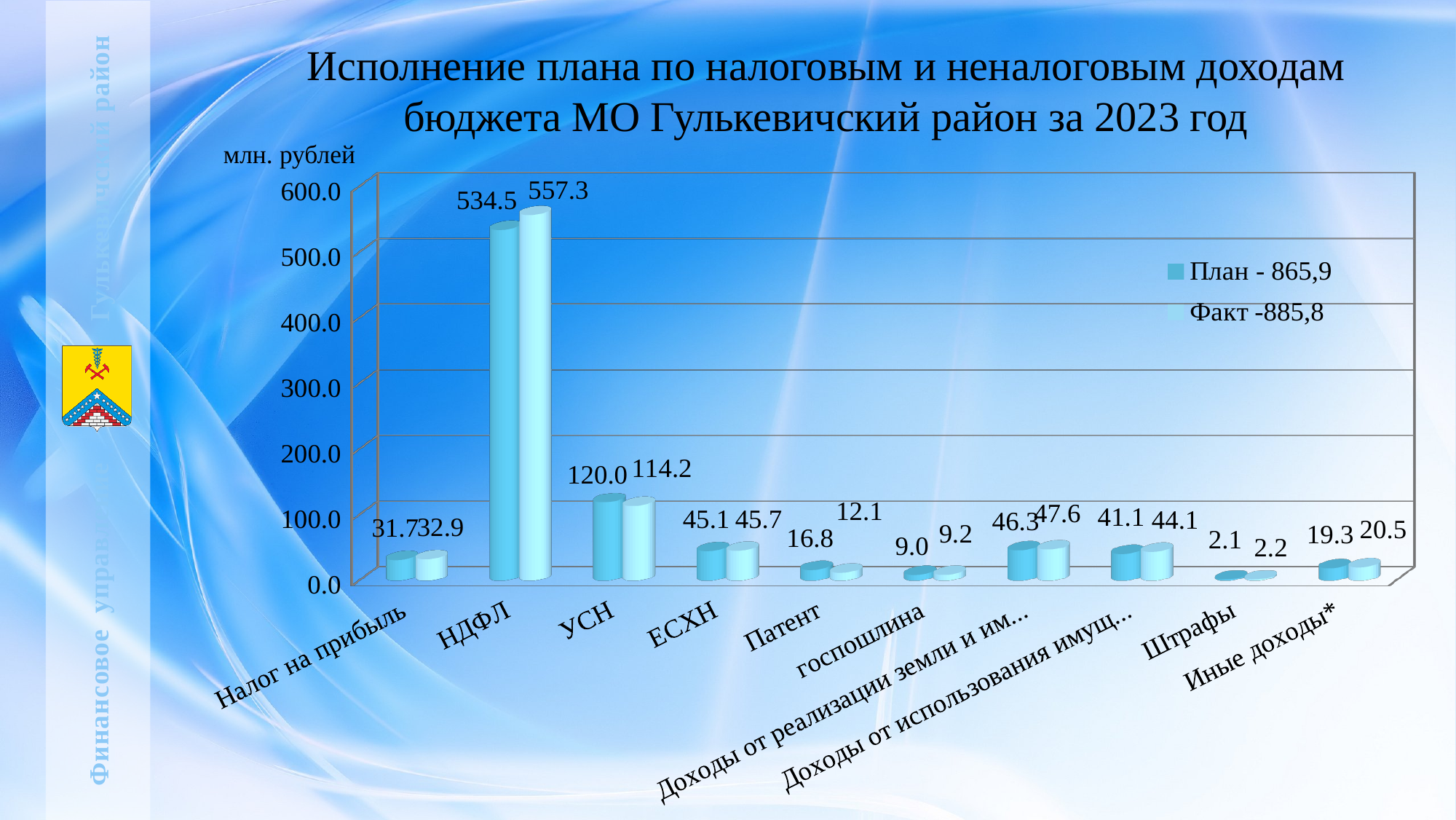
What is the Факт value for Патент? 12.1 How many series does the legend list? 2 Which category has the lowest План value? Штрафы How many categories are shown on the x axis? 10 For УСН, which is larger: the План value or the Факт value? План What is the План value for Штрафы? 2.1 What is the План value for НДФЛ? 534.5 What unit is indicated above the vertical axis? млн. рублей What kind of chart is shown on the slide? Bar chart What is the Факт value for УСН? 114.2 Which category has the highest Факт value? НДФЛ What is the difference between the Факт and План values for НДФЛ? 22.8